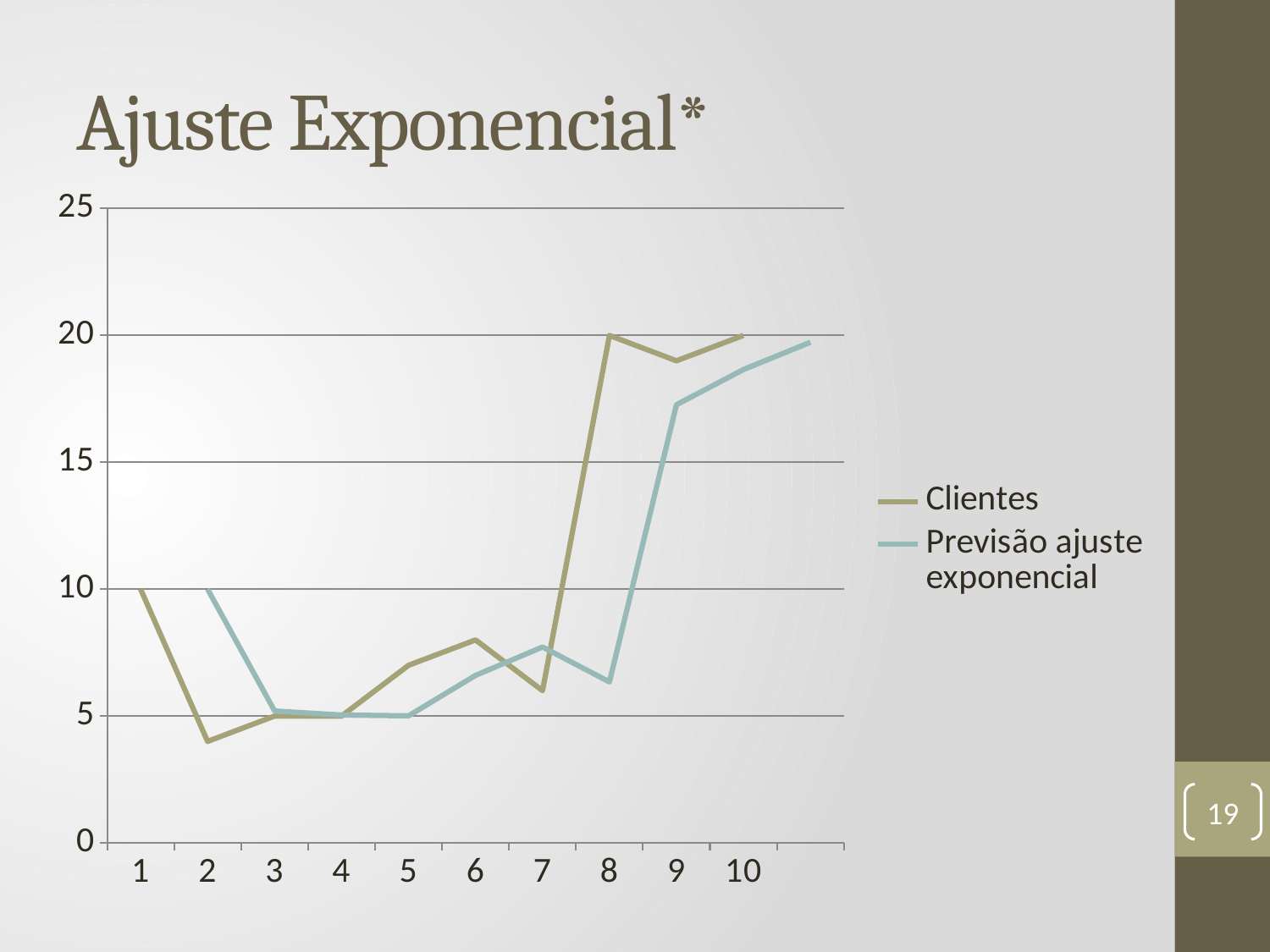
What are the two series named in the legend? Clientes; Previsão ajuste exponencial What is the value of Clientes at period 8? 20 At period 8, which series has the larger value, Clientes or Previsão ajuste exponencial? Clientes What is the value of Clientes at period 1? 10 Is the value of Clientes at period 2 greater or less than 5? less What is the title of the slide containing the chart? Ajuste Exponencial* How many labeled categories are on the x axis? 10 Does the Clientes series rise or fall between period 7 and period 8? rise How many series does the legend list? 2 What kind of chart is shown on the slide? line chart Is the value of Previsão ajuste exponencial at period 9 greater or less than 15? greater At which period is the Clientes series lowest? 2